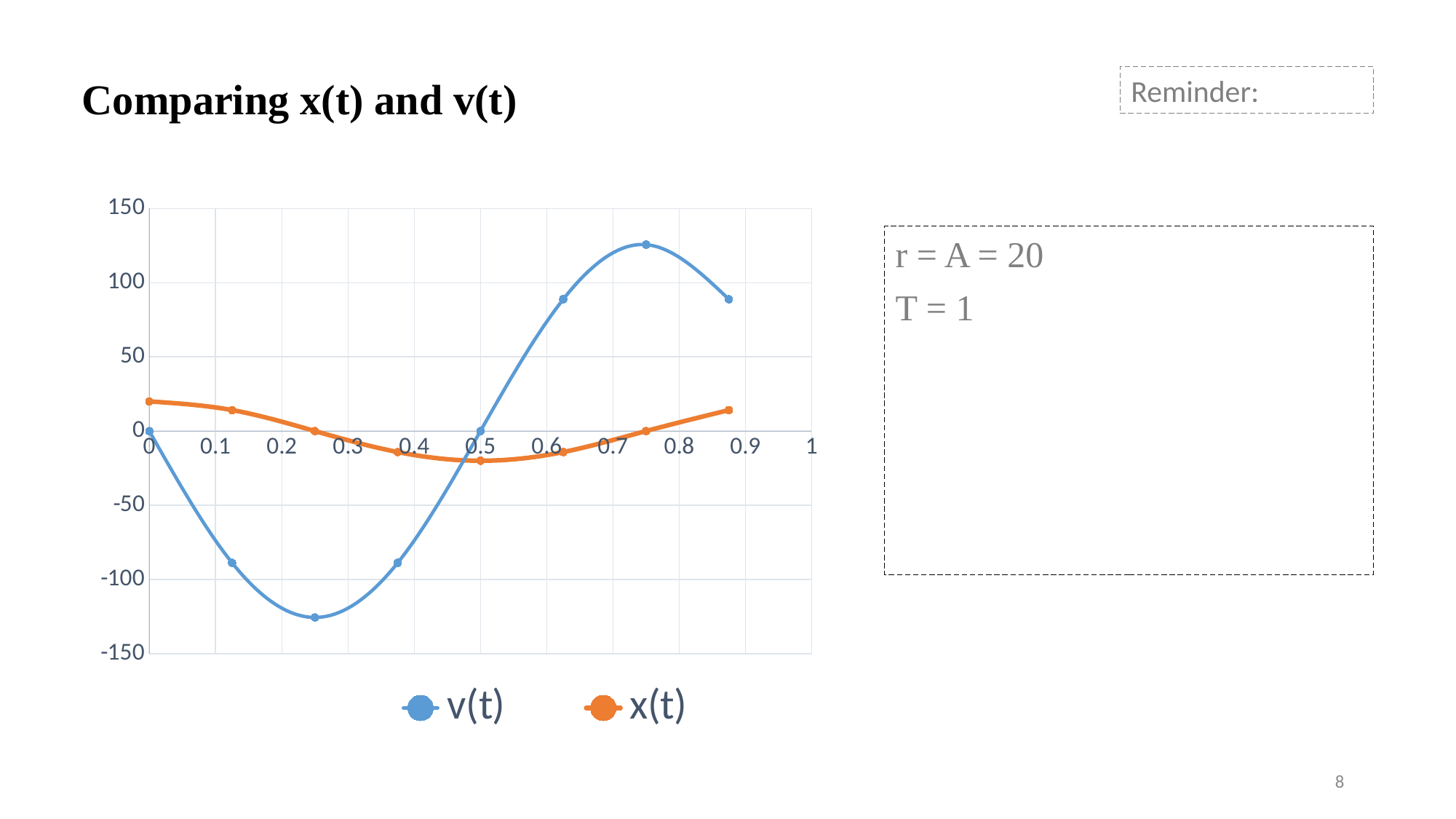
At t = 0.75, which series has the larger value, v(t) or x(t)? v(t) What kind of chart is shown on the slide? line chart Which colour is used for the x(t) series? orange What is the value of v(t) at t = 0? 0 How many data points are plotted for the v(t) series? 8 Is the value of v(t) at t = 0.75 greater or less than 100? greater What is the value of v(t) at t = 0.5? 0 At which t value does v(t) reach its highest point? 0.75 Is the value of x(t) at t = 0 greater or less than 50? less At which t value does v(t) reach its lowest point? 0.25 Is the value of v(t) at t = 0.25 greater or less than -100? less How many series does the chart legend list? 2